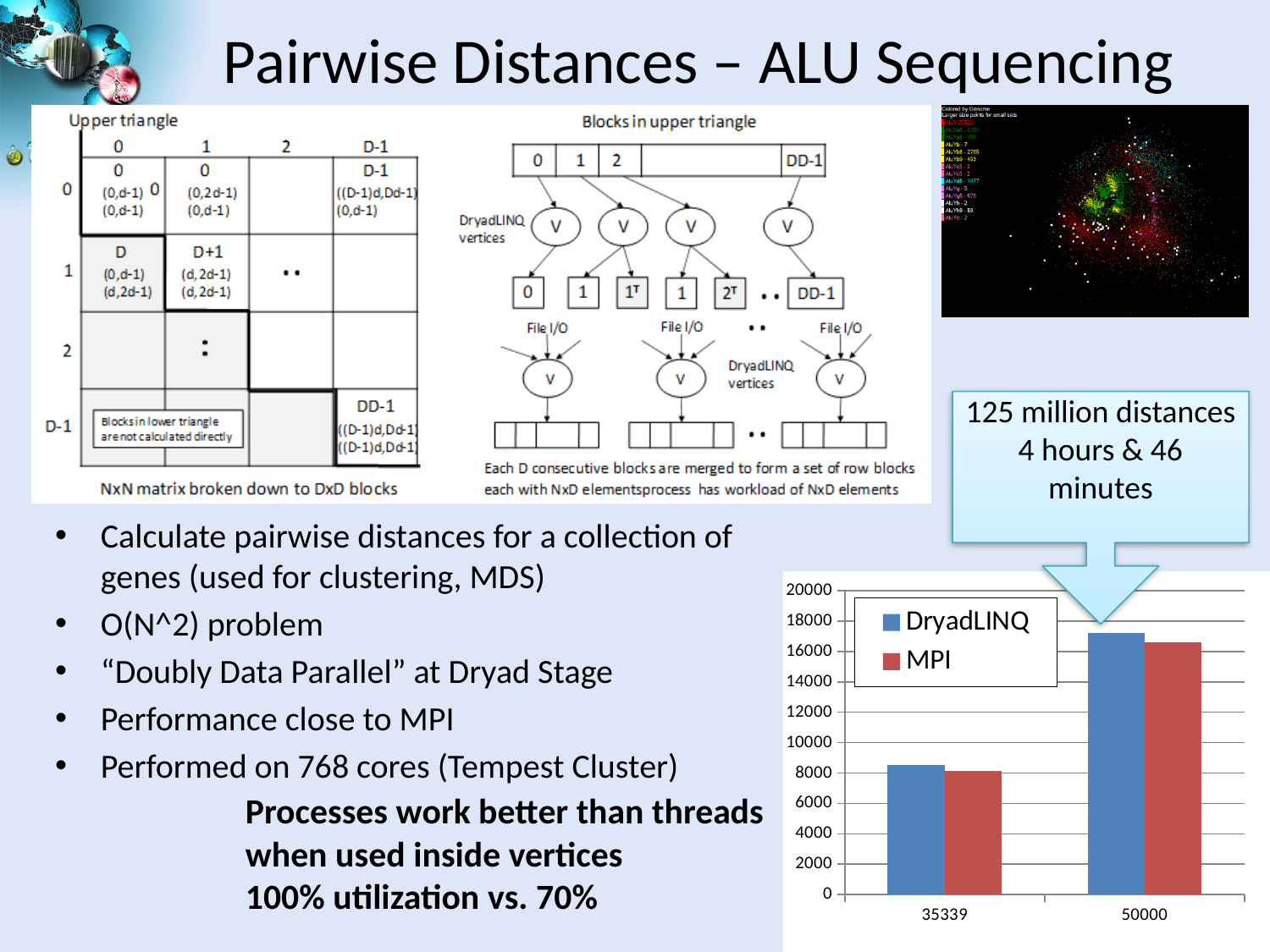
In the bar chart, is the MPI value for 35339 greater or less than 6000? greater In the bar chart, do the values rise or fall from 35339 to 50000? rise Which series are listed in the legend of the bar chart? DryadLINQ and MPI What kind of chart is shown at the bottom right of the slide? bar chart In the bar chart, for the 50000 category, which series has the larger value, DryadLINQ or MPI? DryadLINQ How many categories are shown on the x axis of the bar chart? 2 What are the two category labels on the x axis of the bar chart? 35339 and 50000 In the bar chart, is the DryadLINQ value for 35339 greater or less than 10000? less In the bar chart, is the DryadLINQ value for 50000 greater or less than 16000? greater In the bar chart, which bar is the tallest overall? DryadLINQ at 50000 How many series does the legend of the bar chart list? 2